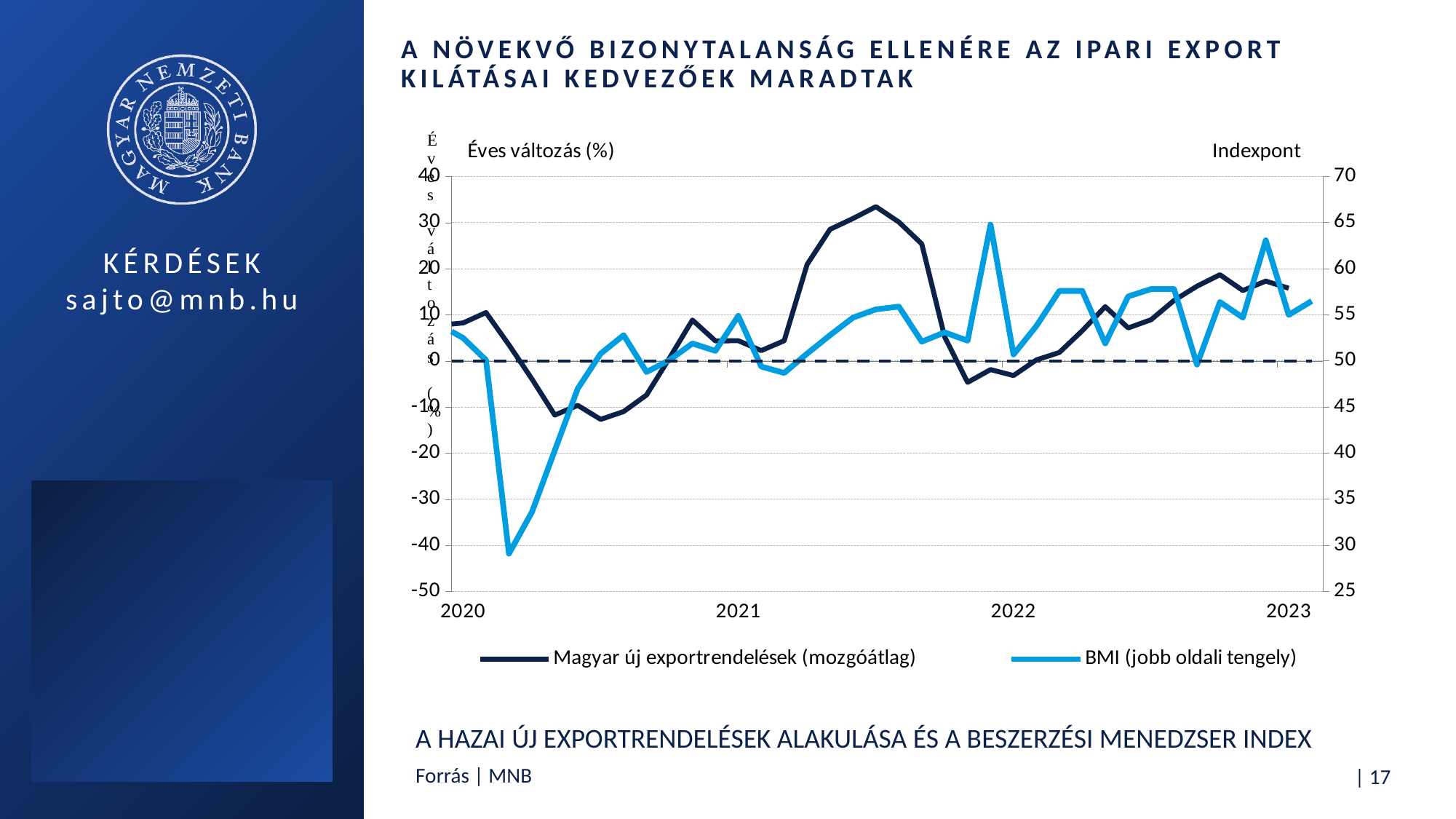
Is the peak of the BMI series near the start of 2022 greater or less than 60? greater How many series does the legend list? 2 What is the label of the left-hand vertical axis? Éves változás (%) What kind of chart is shown on the slide? line chart Which series is plotted on the right-hand axis according to the legend? BMI (jobb oldali tengely) How many year labels are shown on the x axis? 4 Is the highest value of the Magyar új exportrendelések (mozgóátlag) series, reached in 2021, greater or less than 20? greater For the Magyar új exportrendelések (mozgóátlag) series, is the value higher at the start of 2020 or at its peak in mid-2021? at its peak in mid-2021 Is the value of the Magyar új exportrendelések (mozgóátlag) series at the start of 2020 greater or less than 0? greater From the start of 2021 to the middle of 2021, does the Magyar új exportrendelések (mozgóátlag) series rise or fall? rise From the start of 2020 to its lowest point in 2020, does the BMI series rise or fall? fall